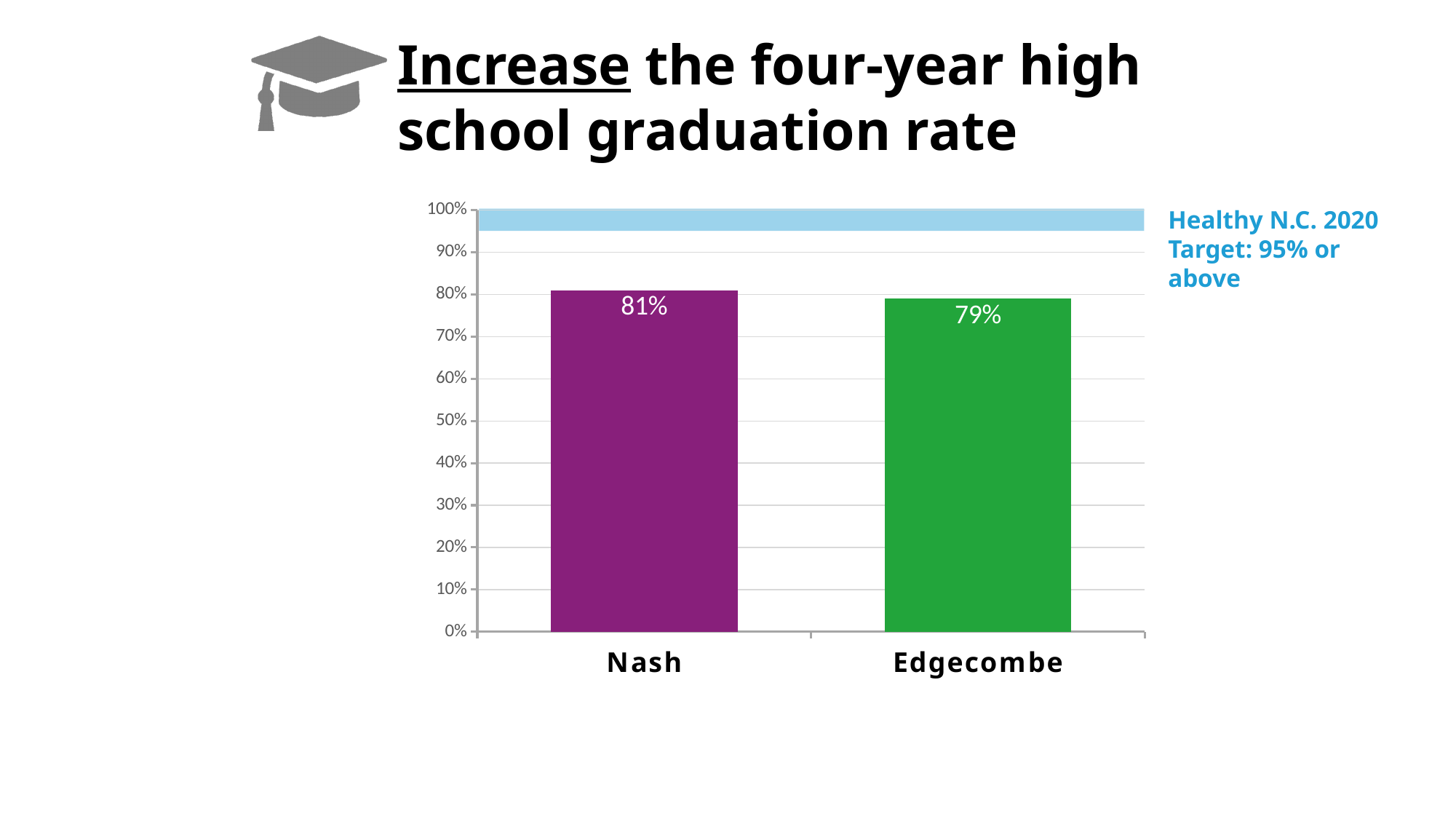
Is the graduation rate for Nash greater or less than 90%? less Is the graduation rate for Edgecombe greater or less than 70%? greater What colour is the bar for Edgecombe? Green What is the difference between the graduation rates of Nash and Edgecombe? 2% Which county has the highest graduation rate shown? Nash What is the Healthy N.C. 2020 target for the graduation rate shown on the chart? 95% or above What kind of chart is shown on the slide? Bar chart Which county has the higher graduation rate, Nash or Edgecombe? Nash What is the four-year high school graduation rate for Edgecombe? 79% Which county has the lowest graduation rate shown? Edgecombe What is the four-year high school graduation rate for Nash? 81% How many counties are shown on the chart? 2